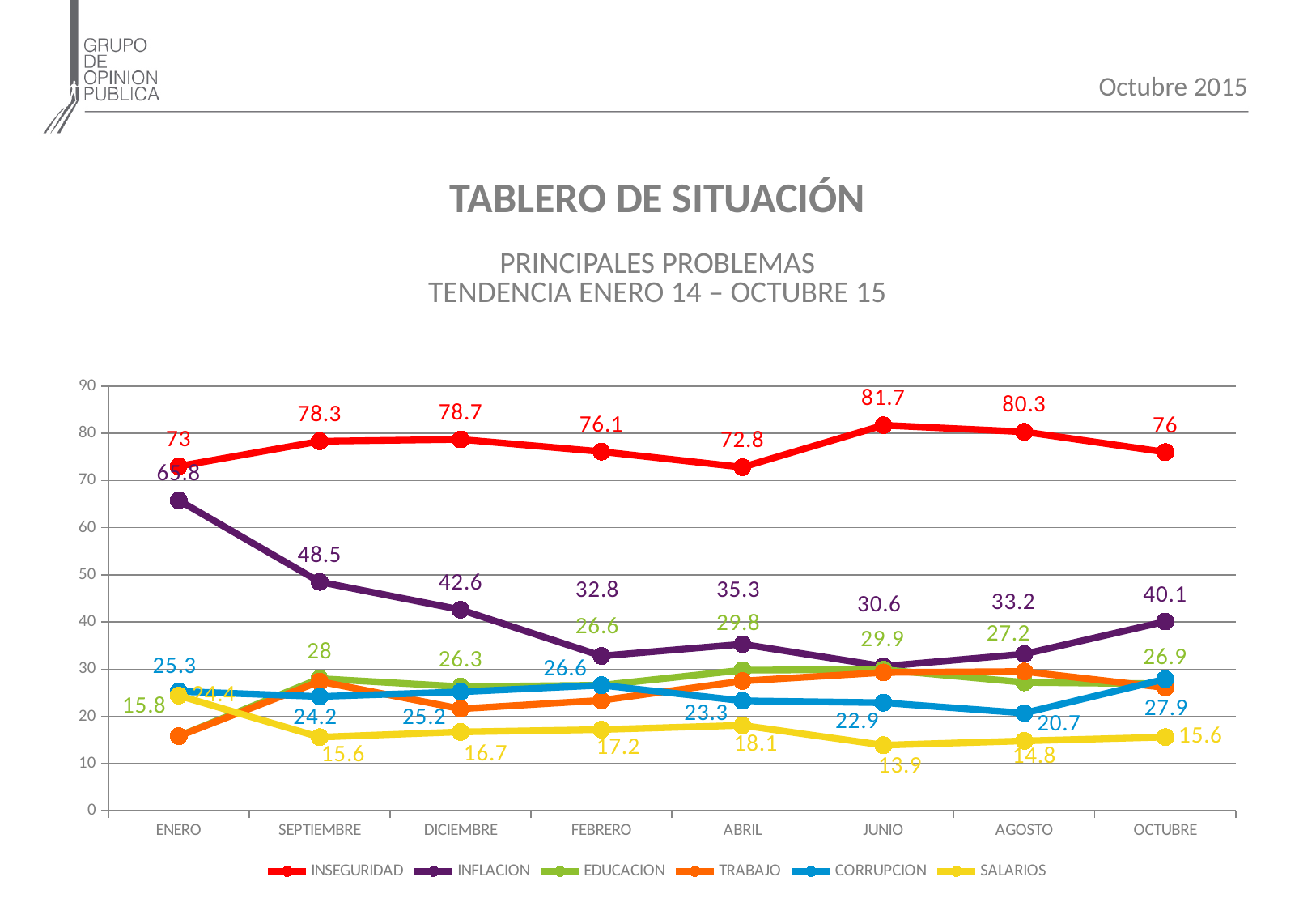
In which month is INSEGURIDAD highest? JUNIO How many months are shown along the x axis? 8 What is the value for INSEGURIDAD in JUNIO? 81.7 In which month is INSEGURIDAD lowest? ABRIL How many series does the legend list? 6 What is the value for CORRUPCION in AGOSTO? 20.7 Which is larger in OCTUBRE, INSEGURIDAD or INFLACION? INSEGURIDAD What is the value for SALARIOS in JUNIO? 13.9 Does INFLACION rise or fall from ENERO to FEBRERO? fall What is the difference between INFLACION in ENERO and INFLACION in OCTUBRE? 25.7 What is the value for INFLACION in ENERO? 65.8 What kind of chart is shown on the slide? line chart